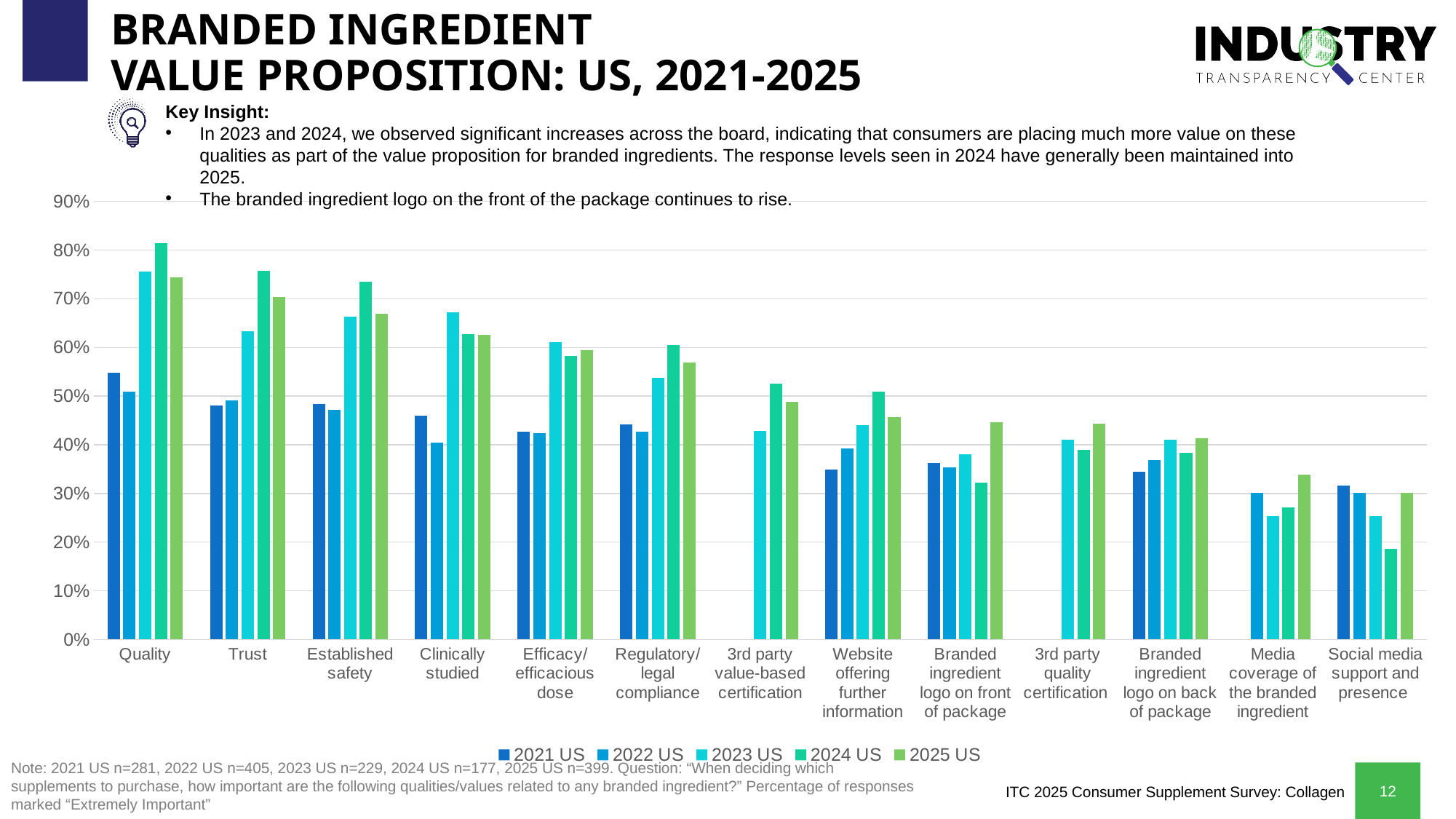
For Trust, which is larger: the 2024 US value or the 2025 US value? 2024 US How many series does the legend list? 5 Which category has the lowest 2024 US value? Social media support and presence Which is larger: the 2023 US value for Efficacy/efficacious dose or the 2023 US value for Regulatory/legal compliance? Efficacy/efficacious dose What type of chart is shown on the slide? Bar chart Is the 2024 US value for Social media support and presence greater or less than 20%? less How many categories are shown along the x axis? 13 Do the 2024 US values generally rise or fall moving from left to right across the categories? fall Is the 2021 US value for Website offering further information greater or less than 40%? less Which category has the highest 2024 US value? Quality What are the legend entries of the chart? 2021 US, 2022 US, 2023 US, 2024 US, 2025 US Is the 2024 US value for Quality greater or less than 70%? greater